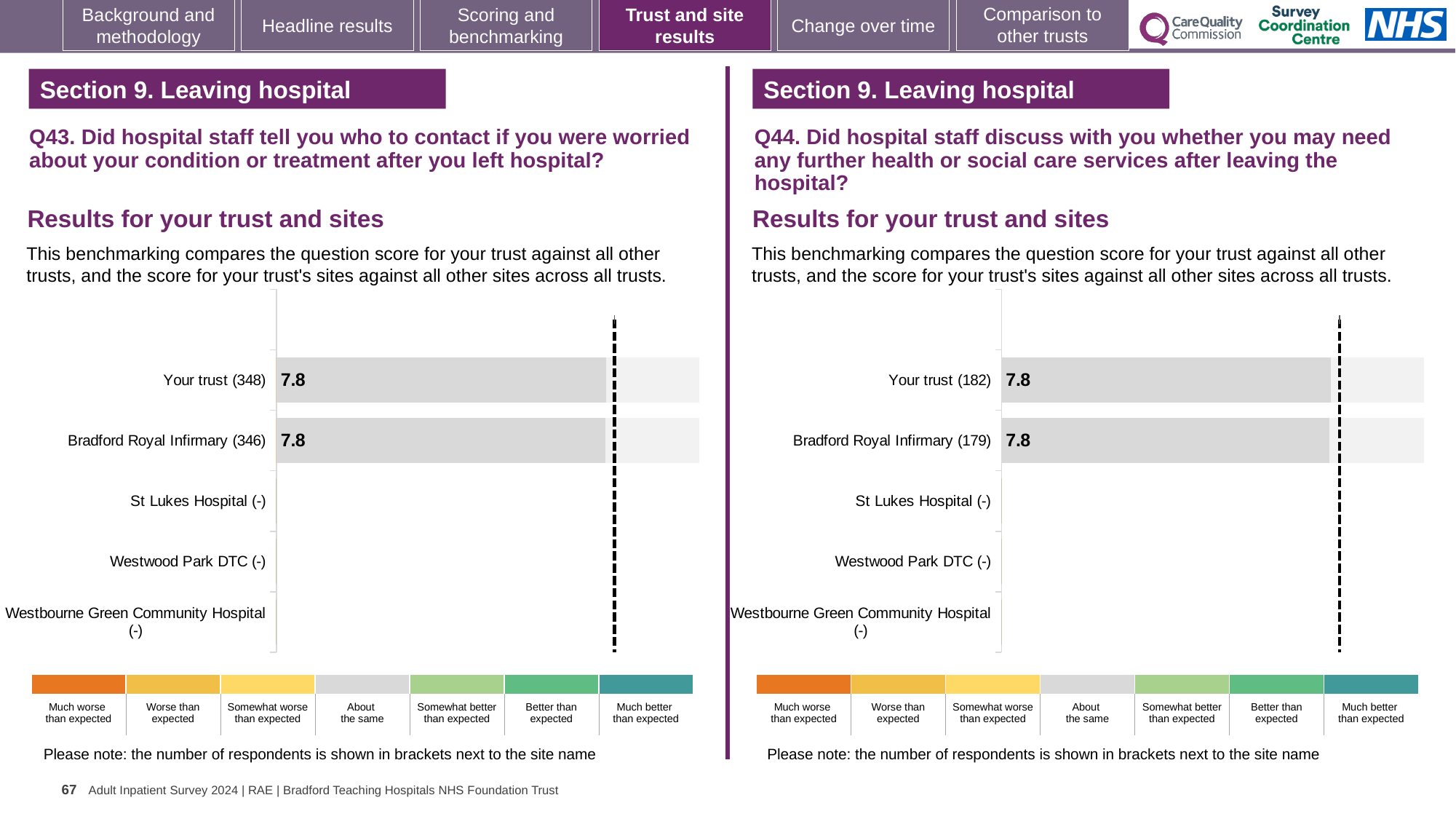
In the Q44 chart on the right, how many respondents are shown in brackets for Bradford Royal Infirmary? 179 In the Q43 chart on the left, how many respondents are shown in brackets for Your trust? 348 In the Q44 chart on the right, what is the score for Your trust? 7.8 In the Q43 chart on the left, how many sites show no score (marked with a dash)? 3 What kind of chart is used in the Q43 chart on the left? Bar chart In the Q44 chart on the right, which benchmark category does the grey colour of the bars correspond to in the key? About the same In the Q43 chart on the left, what is the difference between the scores for Your trust and Bradford Royal Infirmary? 0 In the Q44 chart on the right, what is the score for Bradford Royal Infirmary? 7.8 In the Q43 chart on the left, what is the score for Your trust? 7.8 How many site or trust categories are listed on the y axis of the Q44 chart on the right? 5 In the Q43 chart on the left, what is the score for Bradford Royal Infirmary? 7.8 How many categories does the colour key below the Q43 chart on the left list? 7